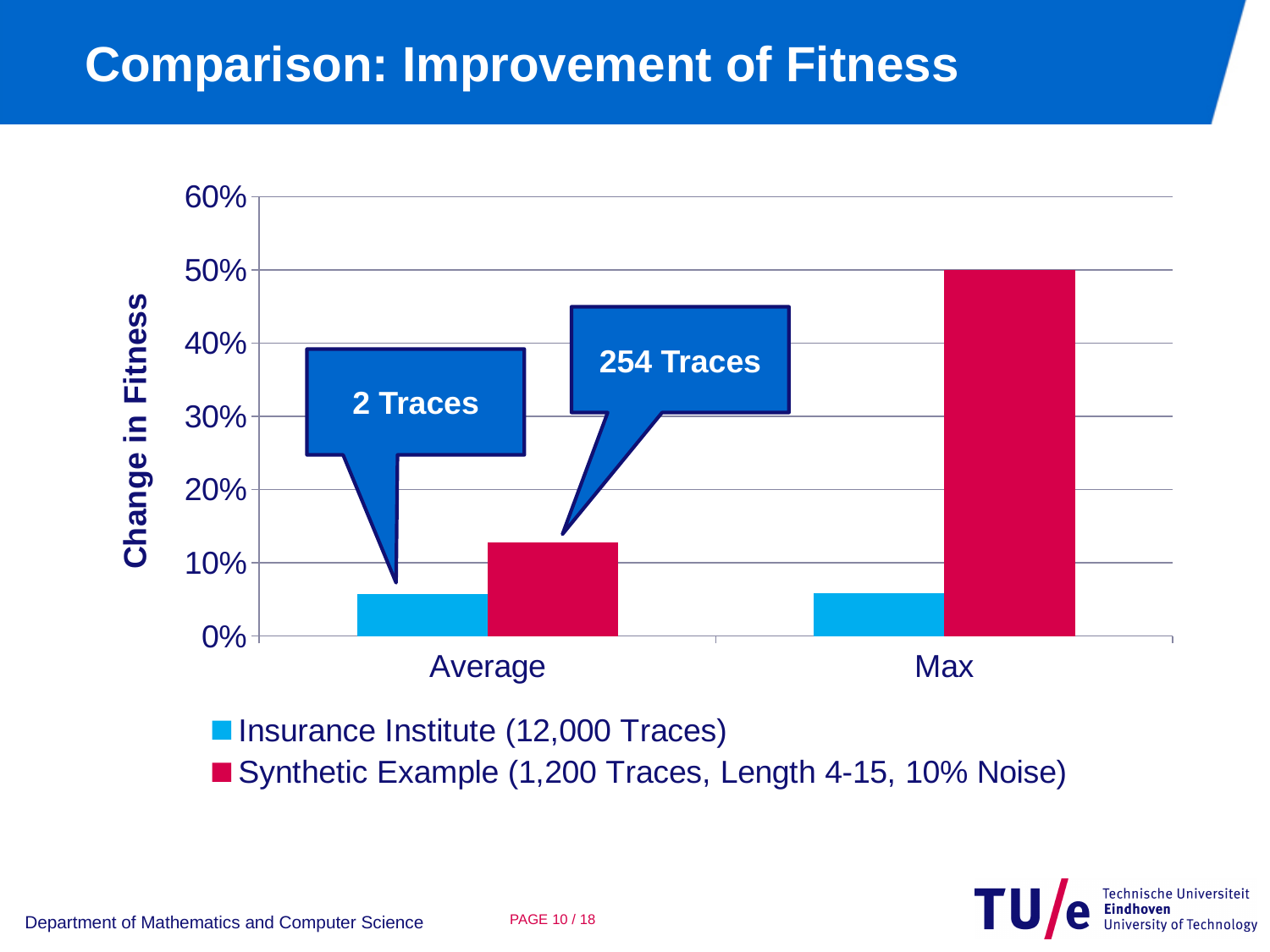
How many series does the chart's legend list? 2 In the Average category, which series has the larger value: Insurance Institute or Synthetic Example? Synthetic Example Is the value for Insurance Institute in the Max category greater or less than 10%? less Is the value for Insurance Institute in the Average category greater or less than 10%? less What is the Change in Fitness for the Synthetic Example series in the Max category? 50% Is the value for Synthetic Example in the Average category greater or less than 10%? greater What does the callout pointing to the Synthetic Example bar in the Average category say? 254 Traces What kind of chart is shown on the slide? bar chart Which series and category combination has the highest bar in the chart? Synthetic Example, Max How many categories are shown on the x axis of the chart? 2 In the Max category, which series has the larger value: Insurance Institute or Synthetic Example? Synthetic Example What is the title of the chart's vertical axis? Change in Fitness